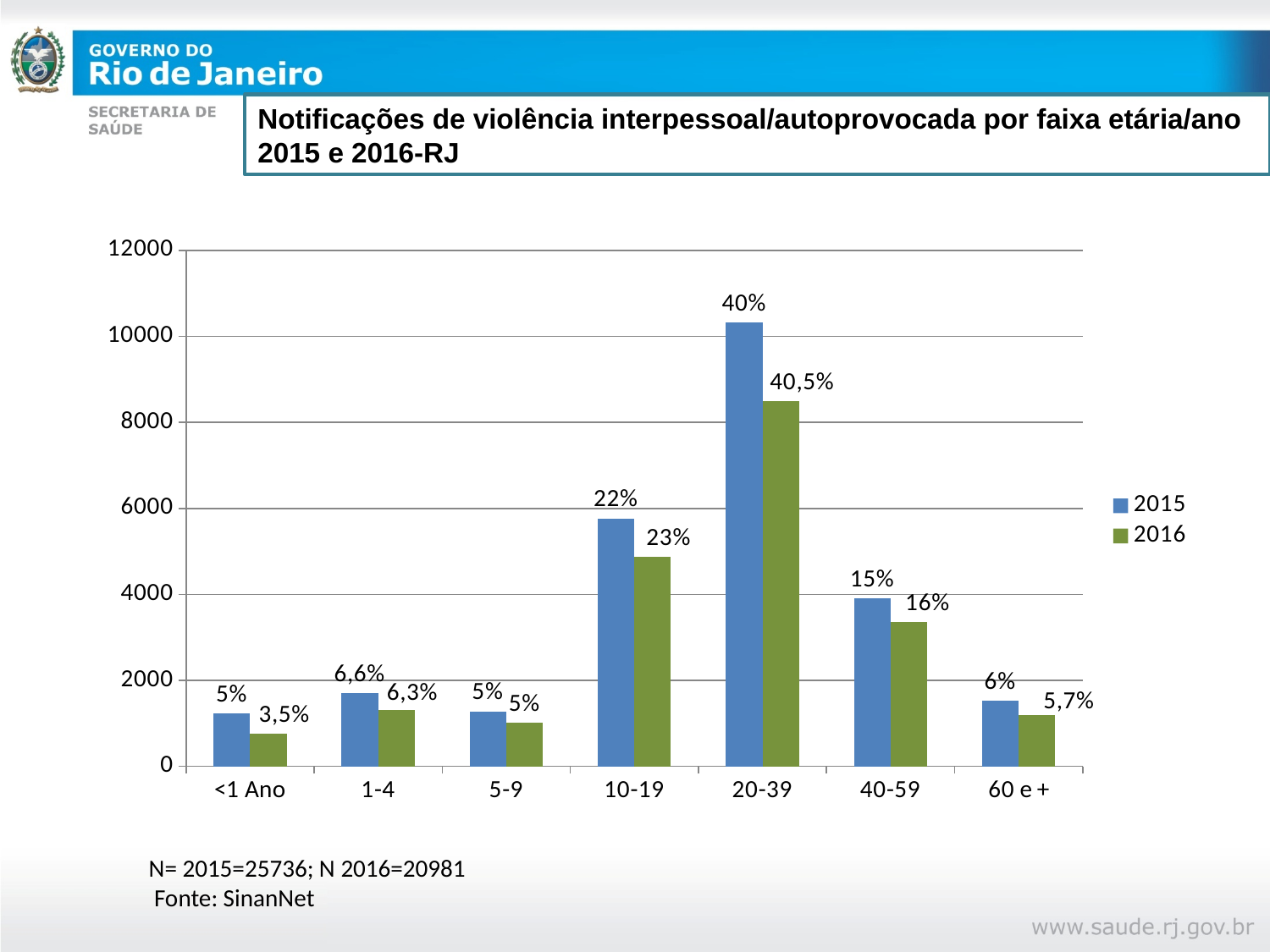
What data label is shown for the 2016 bar in the 20-39 age group? 40,5% What data label is shown for the 2015 bar in the 20-39 age group? 40% How many series does the legend list? 2 Which age group has the shortest bar for 2016? <1 Ano Is the 2015 bar for the 20-39 age group greater or less than 10000? greater For the 10-19 age group, which year has the taller bar, 2015 or 2016? 2015 Which age group has the tallest bar for 2015? 20-39 Is the 2016 bar for the 40-59 age group greater or less than 4000? less What data label is shown for the 2015 bar in the 1-4 age group? 6,6% What data label is shown for the 2016 bar in the 60 e + age group? 5,7% How many age groups are shown on the x axis? 7 What data label is shown for the 2016 bar in the <1 Ano age group? 3,5%